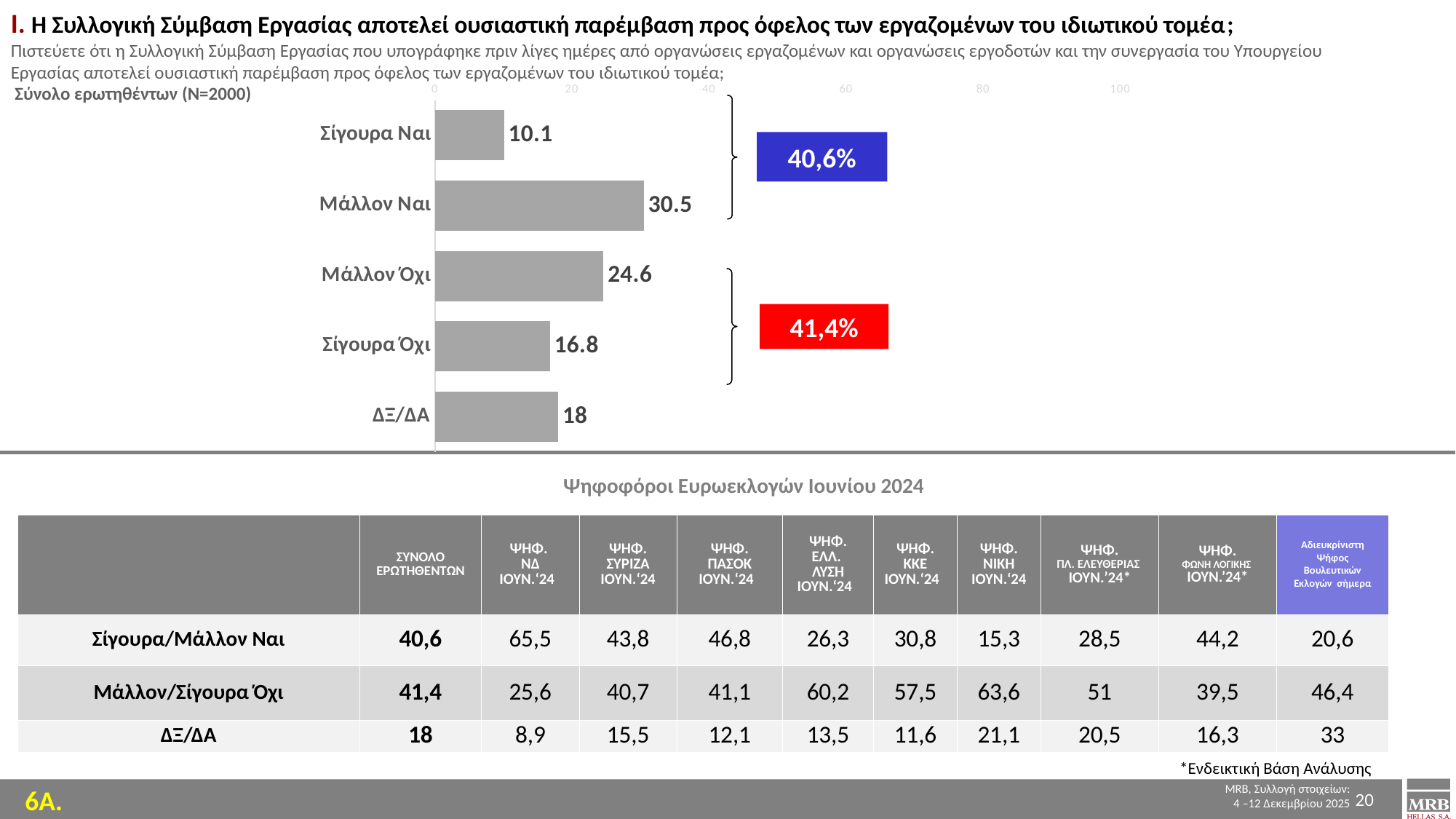
What kind of chart is shown on the slide? Bar chart Which is larger in the bar chart, the value for Σίγουρα Όχι or the value for ΔΞ/ΔΑ? ΔΞ/ΔΑ What value does the bar chart show for ΔΞ/ΔΑ? 18 What is the difference between the values for Μάλλον Ναι and Μάλλον Όχι in the bar chart? 5.9 How many categories are shown in the bar chart? 5 What is the combined total of Σίγουρα Ναι and Μάλλον Ναι in the bar chart? 40.6 What value does the bar chart show for Μάλλον Ναι? 30.5 Which category has the highest value in the bar chart? Μάλλον Ναι What value does the bar chart show for Σίγουρα Όχι? 16.8 What percentage is shown in the red box next to the bar chart? 41,4% Which category has the lowest value in the bar chart? Σίγουρα Ναι Is the value for Μάλλον Όχι in the bar chart greater or less than 20? greater